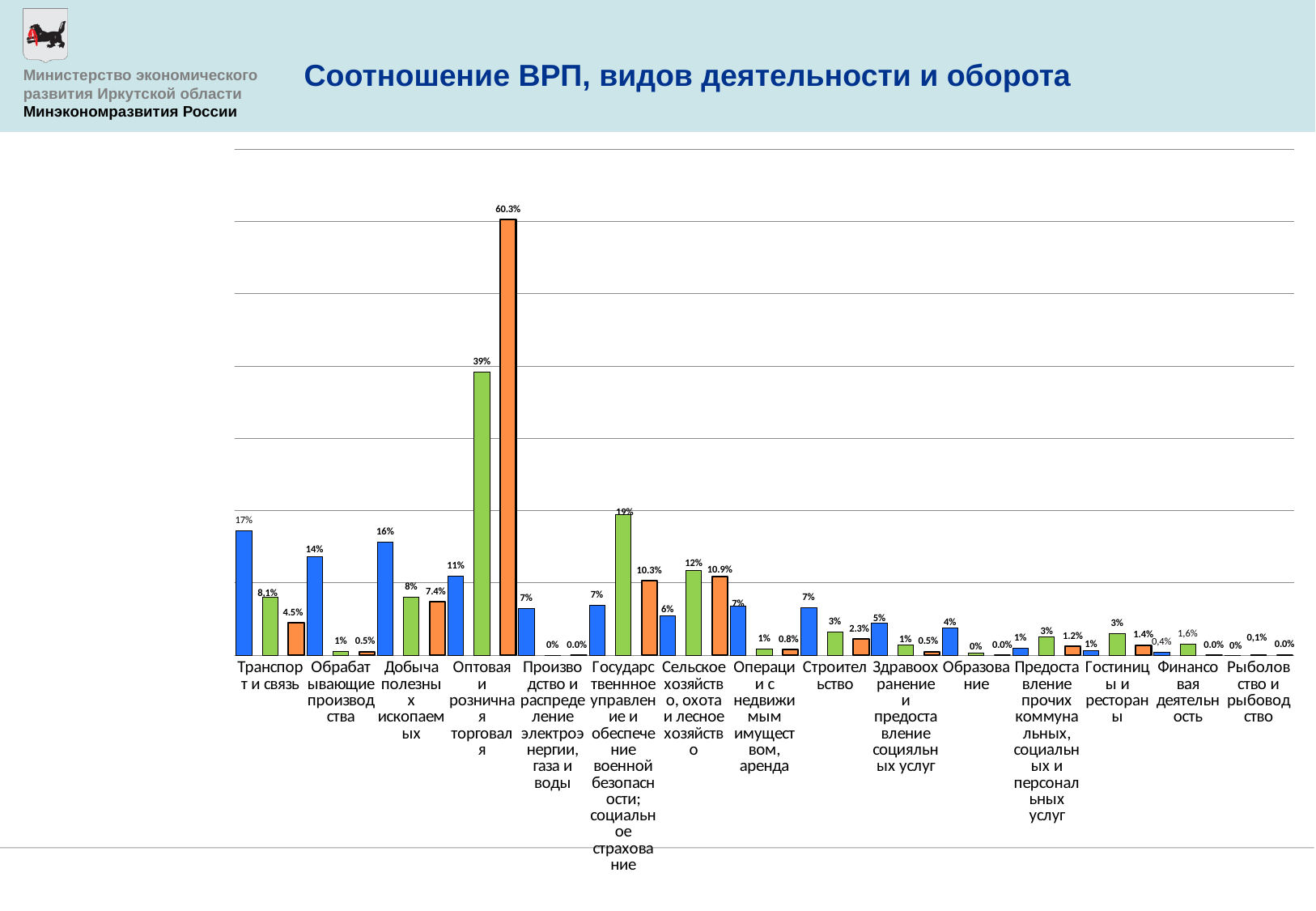
What is the value of the blue bar for Транспорт и связь? 17% What is the title of the slide's chart? Соотношение ВРП, видов деятельности и оборота How many categories are shown on the x axis? 15 What is the value of the blue bar for Строительство? 7% What is the value of the green bar for Государственное управление и обеспечение военной безопасности; социальное страхование? 19% Which category has the highest blue bar? Транспорт и связь What kind of chart is shown on the slide? bar chart What is the value of the orange bar for Сельское хозяйство, охота и лесное хозяйство? 10.9% What is the difference between the green bar and the blue bar for Оптовая и розничная торговля? 28% Which category has the highest green bar? Оптовая и розничная торговля Which is larger for Добыча полезных ископаемых: the blue bar or the orange bar? the blue bar What is the value of the orange bar for Оптовая и розничная торговля? 60.3%